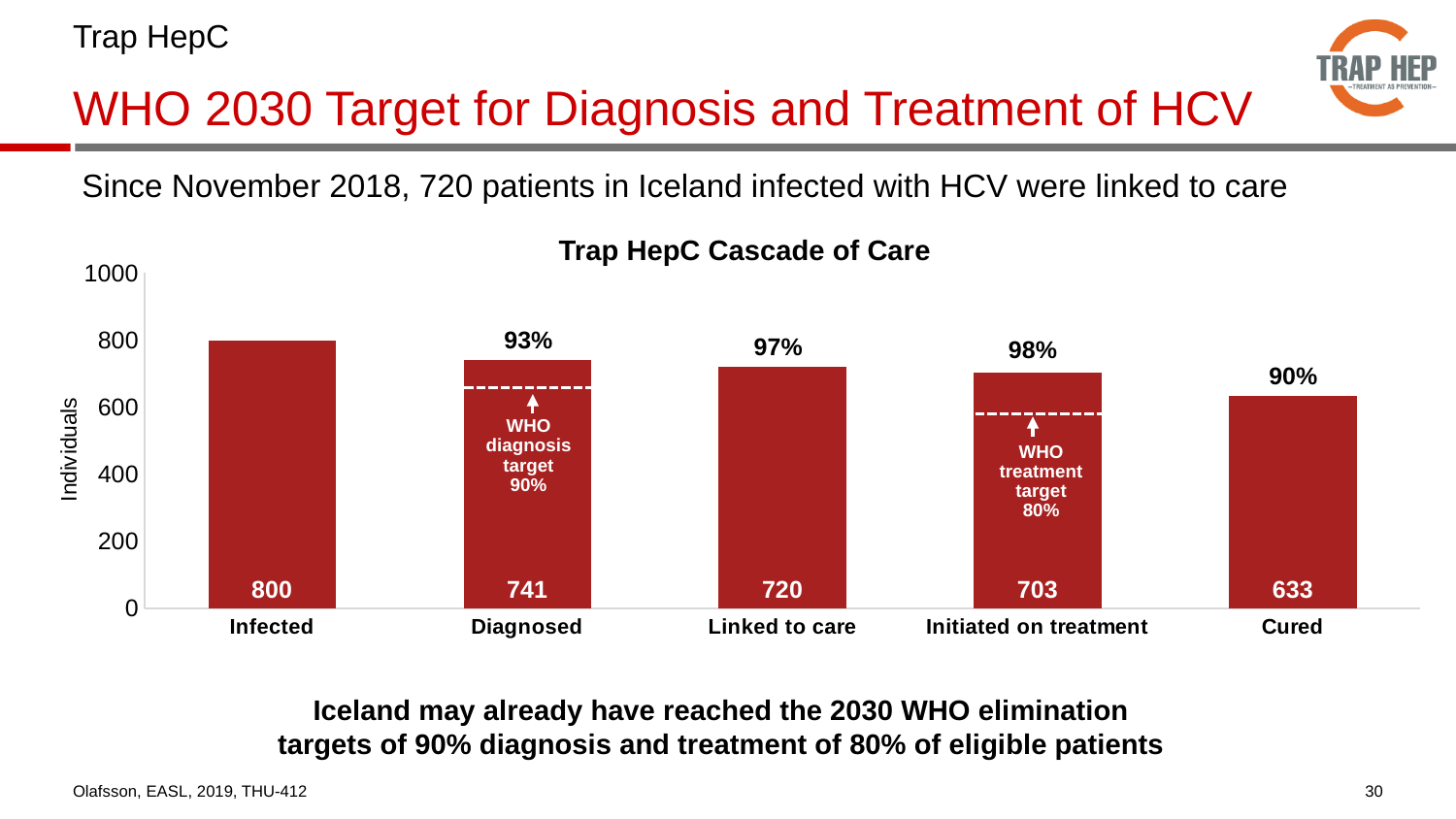
What percentage is shown above the Initiated on treatment bar? 98% How many categories are shown on the x axis? 5 Which category has the highest value? Infected What is the value for Cured? 633 What is the value for Infected in the Trap HepC Cascade of Care chart? 800 Do the values rise or fall from left to right along the x axis? Fall What is the difference between the Infected and Cured values? 167 What kind of chart is shown on the slide? Bar chart Which is larger, the value for Diagnosed or the value for Linked to care? Diagnosed Which category has the lowest value? Cured What is the difference between Linked to care and Initiated on treatment? 17 How many individuals were Diagnosed according to the chart? 741